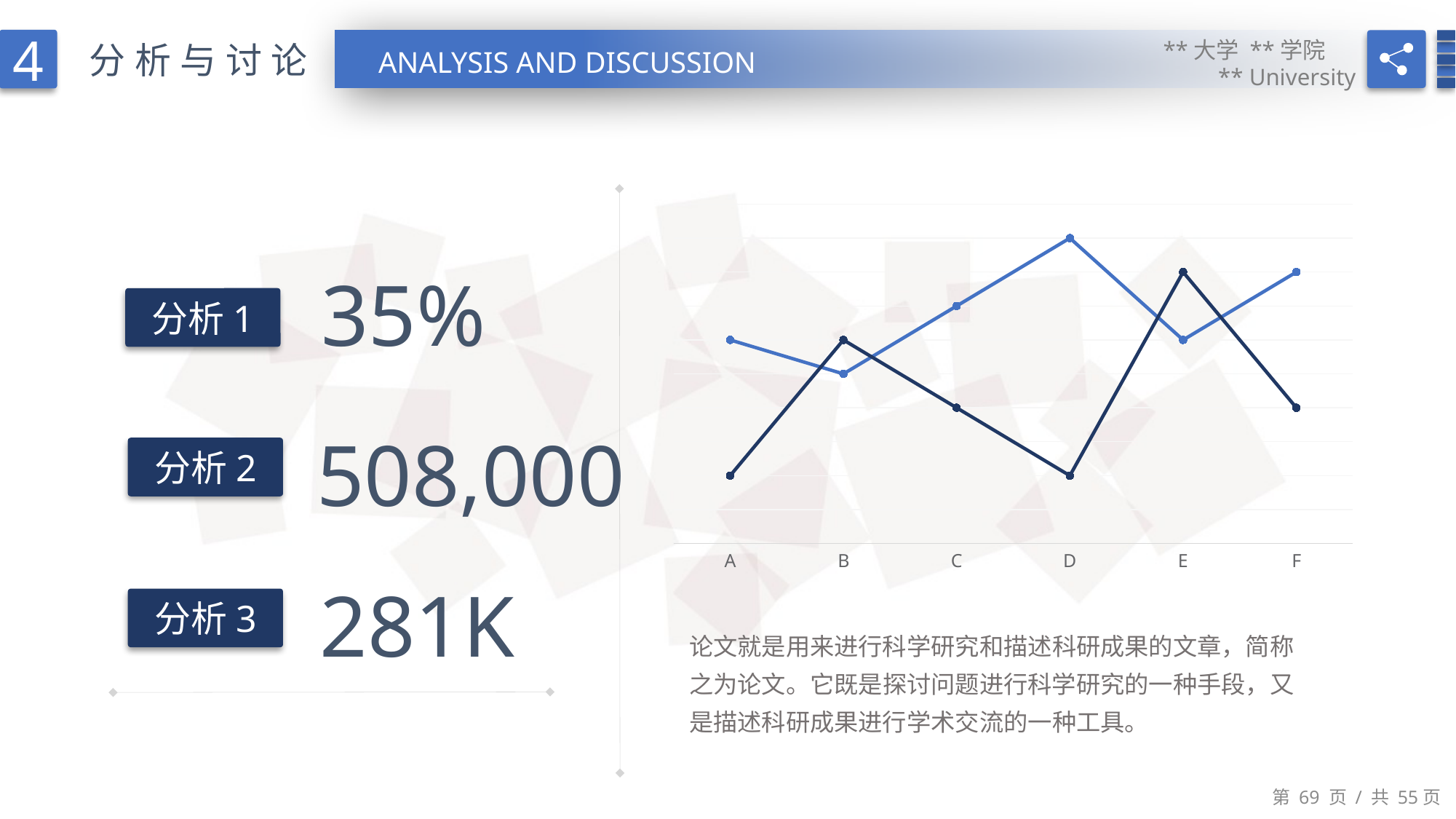
At category E, which line is higher, the light blue line or the dark blue line? dark blue line What are the labels on the x axis of the line chart? A, B, C, D, E, F At which category does the light blue line reach its lowest point? B What kind of chart is shown on the slide? line chart Does the light blue line rise or fall from C to D? rise At which category does the dark blue line reach its highest point? E At which category does the light blue line reach its highest point? D How many categories are shown on the x axis of the line chart? 6 How many lines are plotted in the line chart? 2 Does the dark blue line rise or fall from B to D? fall At category D, which line is higher, the light blue line or the dark blue line? light blue line At category B, which line is higher, the light blue line or the dark blue line? dark blue line